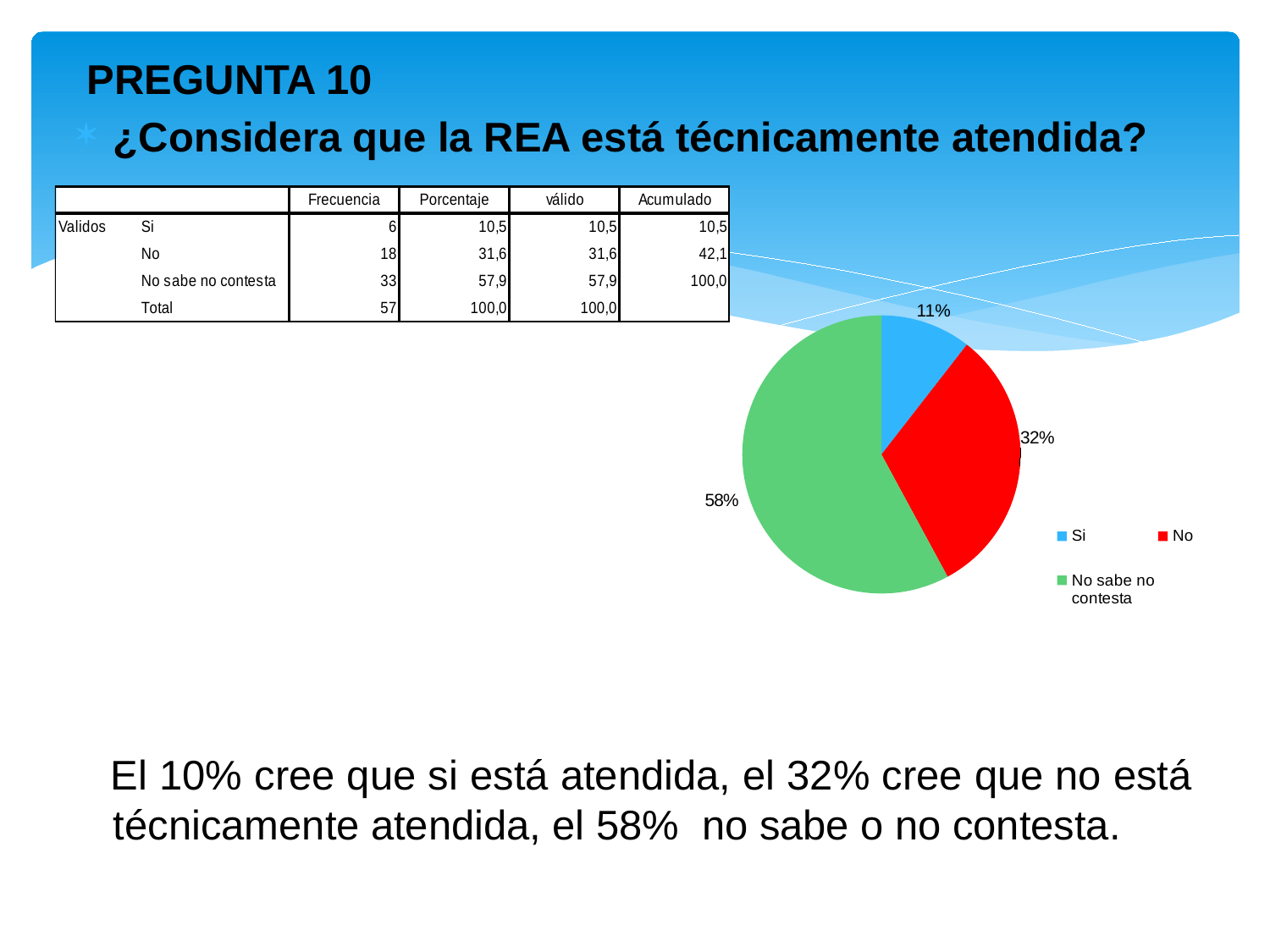
Which category has the smallest slice of the pie? Si Which category has the largest slice of the pie? No sabe no contesta What colour is the "No" slice in the pie chart? red What is the difference in percentage points between the "No" slice and the "Si" slice? 21% What is the difference in percentage points between the "No sabe no contesta" slice and the "No" slice? 26% How many slices does the pie chart have? 3 Which slice is larger, "No" or "Si"? No What share of the pie does the "Si" slice represent? 11% What share of the pie does the "No" slice represent? 32% What share of the pie does the "No sabe no contesta" slice represent? 58% What kind of chart is shown on the slide? pie chart How many entries does the legend list? 3